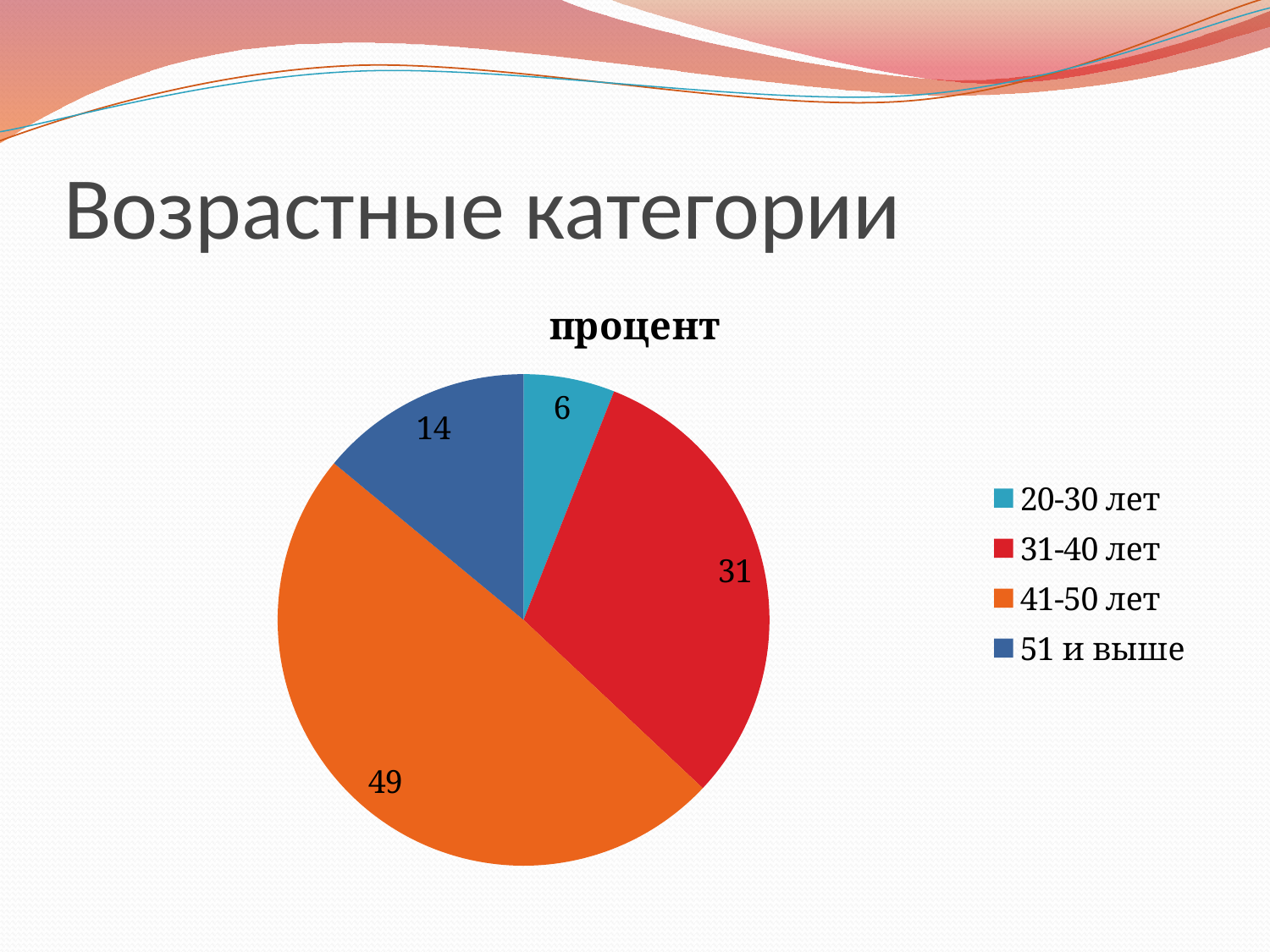
Which age category has the largest slice? 41-50 лет What value is shown for the 31-40 лет slice? 31 What value is shown for the 41-50 лет slice? 49 Which age category has the smallest slice? 20-30 лет What value is shown for the 51 и выше slice? 14 What kind of chart is shown on the slide? Pie chart Which colour represents the 31-40 лет category? Red What is the title of the chart? процент What is the difference between the values for 41-50 лет and 31-40 лет? 18 How many slices does the pie chart have? 4 Which is larger, the value for 51 и выше or the value for 20-30 лет? 51 и выше What value is shown for the 20-30 лет slice? 6